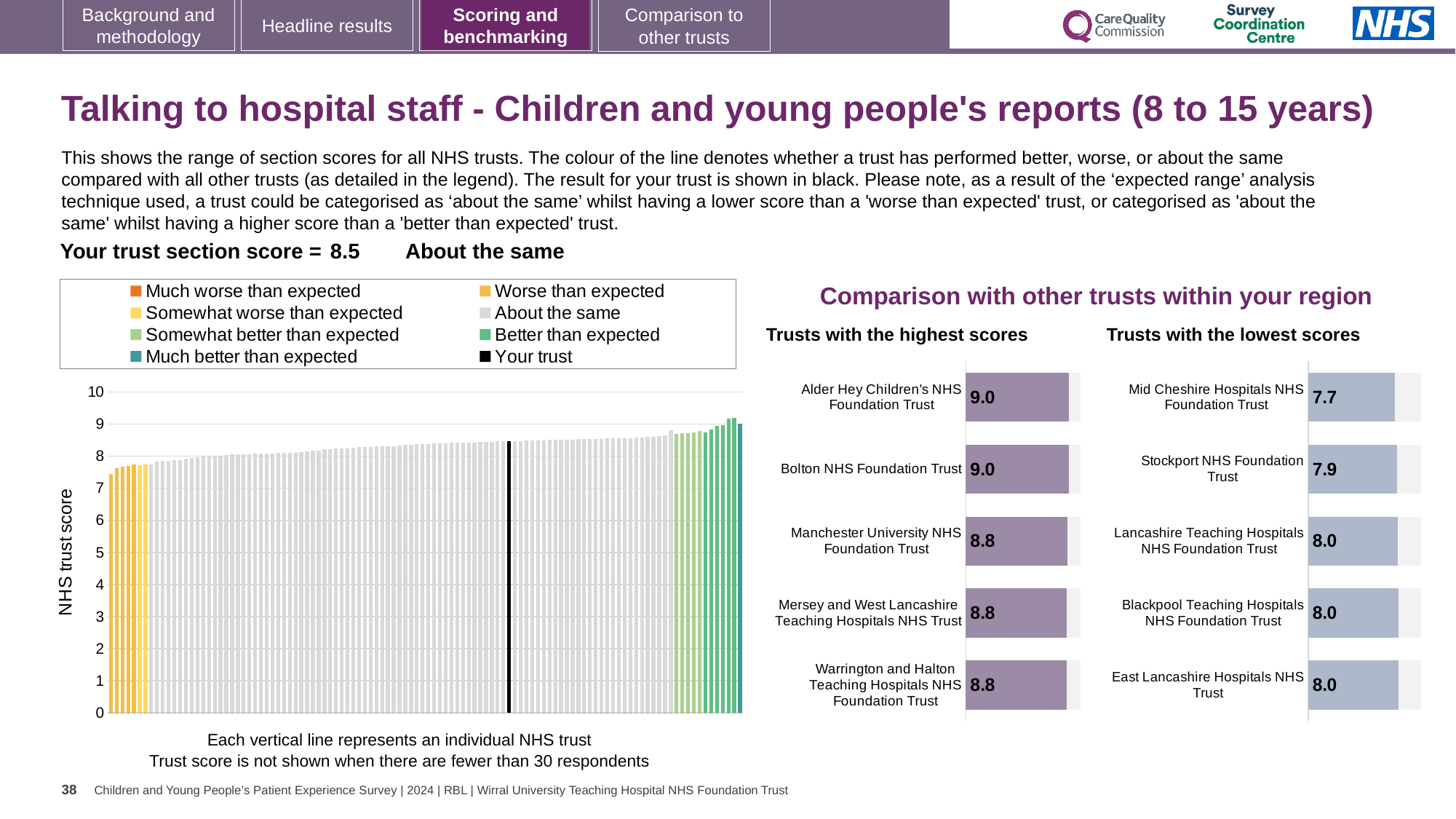
In the 'Trusts with the highest scores' chart, what is the score for Alder Hey Children's NHS Foundation Trust? 9.0 What kind of chart is the main 'NHS trust score' chart on the left? bar chart How many entries does the legend of the main 'NHS trust score' chart list? 8 In the 'Trusts with the highest scores' chart, what is the score for Manchester University NHS Foundation Trust? 8.8 In the 'Trusts with the lowest scores' chart, what is the difference between the scores for Stockport NHS Foundation Trust and Mid Cheshire Hospitals NHS Foundation Trust? 0.2 In the 'Trusts with the lowest scores' chart, which trust has the lowest score? Mid Cheshire Hospitals NHS Foundation Trust Which has the higher score: Bolton NHS Foundation Trust in the highest scores chart or Blackpool Teaching Hospitals NHS Foundation Trust in the lowest scores chart? Bolton NHS Foundation Trust In the 'Trusts with the lowest scores' chart, what is the score for Stockport NHS Foundation Trust? 7.9 In the main 'NHS trust score' chart on the left, is the value for the black 'Your trust' bar greater or less than 8? greater In the main 'NHS trust score' chart on the left, do the bar values rise or fall from left to right? rise How many trusts are listed in the 'Trusts with the highest scores' chart? 5 In the main 'NHS trust score' chart on the left, what is the section score for your trust? 8.5